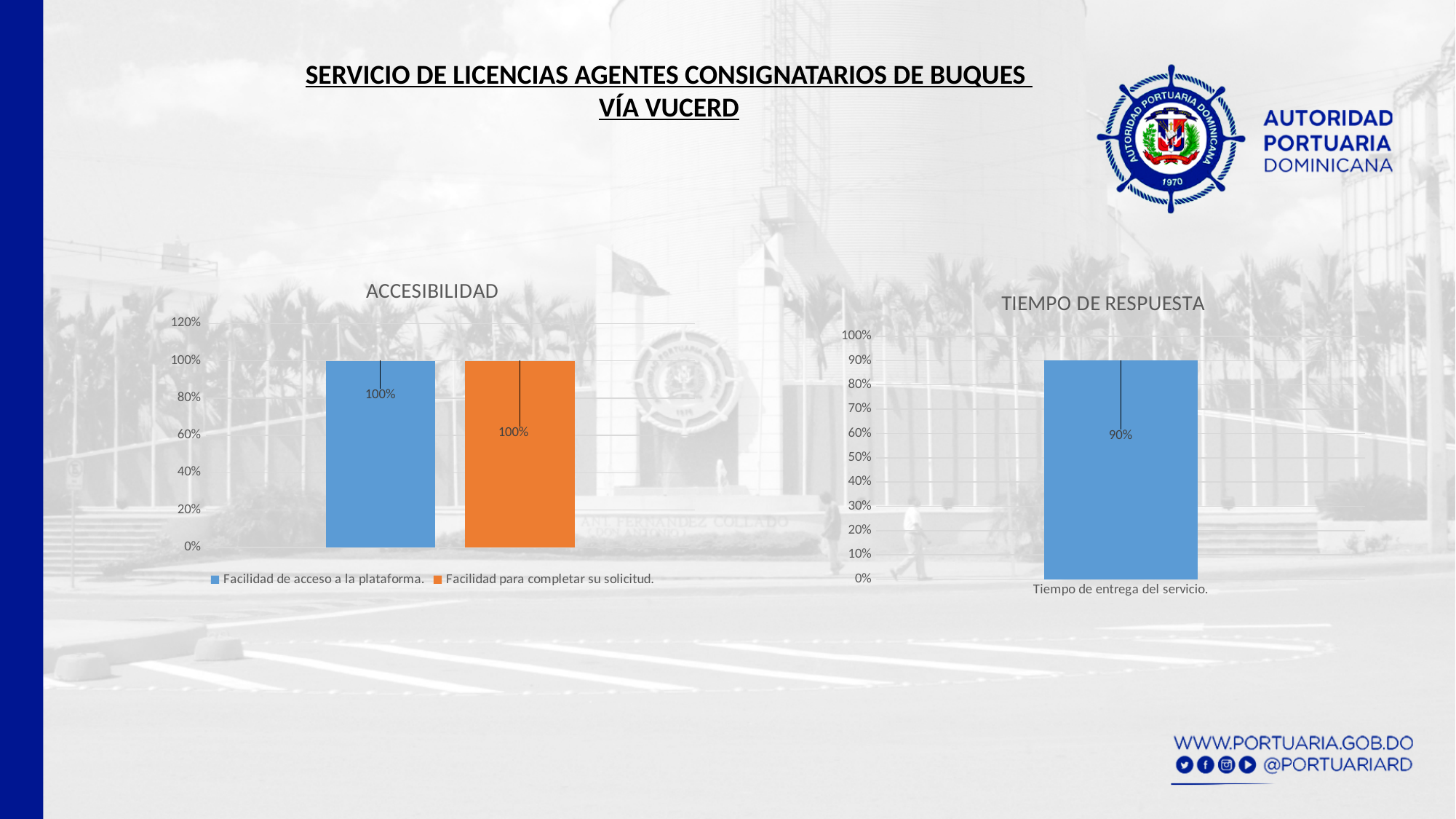
What kind of chart is the ACCESIBILIDAD chart? Bar chart In the ACCESIBILIDAD chart, what colour is the bar for "Facilidad para completar su solicitud."? Orange How many bars are plotted in the TIEMPO DE RESPUESTA chart? 1 In the ACCESIBILIDAD chart, what is the value for "Facilidad para completar su solicitud."? 100% In the TIEMPO DE RESPUESTA chart, is the value for "Tiempo de entrega del servicio." greater or less than 50%? greater What kind of chart is the TIEMPO DE RESPUESTA chart? Bar chart What is the highest value shown on the vertical axis of the ACCESIBILIDAD chart? 120% How many series does the legend of the ACCESIBILIDAD chart list? 2 What is the difference between the value in the TIEMPO DE RESPUESTA chart and the value for "Facilidad de acceso a la plataforma." in the ACCESIBILIDAD chart? 10% In the ACCESIBILIDAD chart, what is the value for "Facilidad de acceso a la plataforma."? 100% In the TIEMPO DE RESPUESTA chart, what is the value for "Tiempo de entrega del servicio."? 90% Which is larger: the value for "Facilidad para completar su solicitud." in the ACCESIBILIDAD chart or the value for "Tiempo de entrega del servicio." in the TIEMPO DE RESPUESTA chart? Facilidad para completar su solicitud.